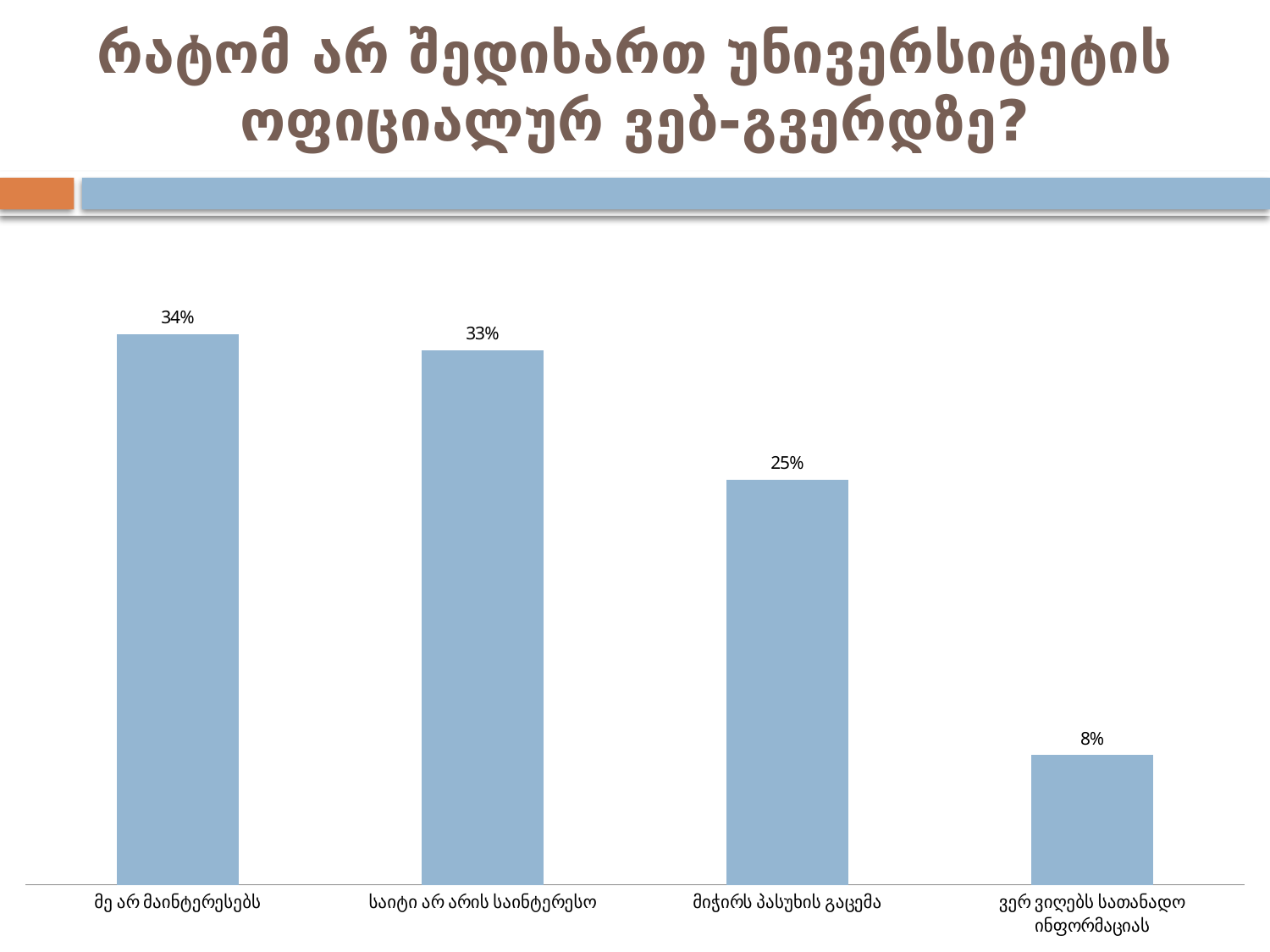
What is the difference between the values for "მე არ მაინტერესებს" and "ვერ ვიღებ სათანადო ინფორმაციას"? 26% What kind of chart is shown on the slide? Bar chart Which category has the lowest value? ვერ ვიღებს სათანადო ინფორმაციას Do the values rise or fall from left to right across the categories? Fall What is the value for "მე არ მაინტერესებს"? 34% What is the value for "საიტი არ არის საინტერესო"? 33% Which category has the highest value? მე არ მაინტერესებს What is the difference between the values for "საიტი არ არის საინტერესო" and "მიჭირს პასუხის გაცემა"? 8% Which is larger, the value for "მიჭირს პასუხის გაცემა" or the value for "ვერ ვიღებ სათანადო ინფორმაციას"? მიჭირს პასუხის გაცემა What is the value for "მიჭირს პასუხის გაცემა"? 25% What is the value for "ვერ ვიღებ სათანადო ინფორმაციას"? 8% How many categories are shown in the chart? 4